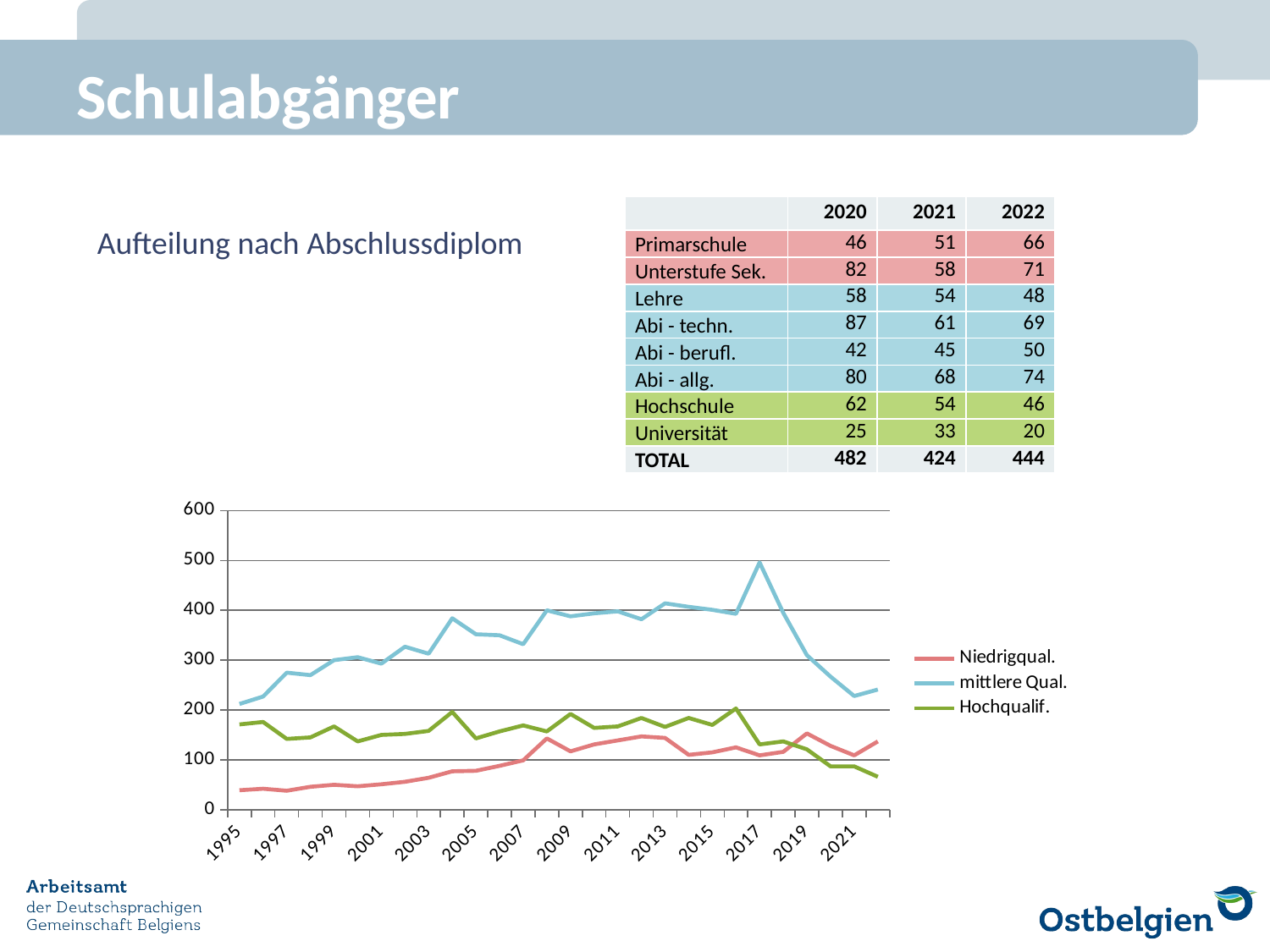
Does the mittlere Qual. series rise or fall between 2017 and 2022? fall Is the value for Hochqualif. in 2022 greater or less than 100? less Is the value for mittlere Qual. in 2017 greater or less than 400? greater Is the value for mittlere Qual. in 2021 greater or less than 200? greater Which colour is used for the mittlere Qual. series in the chart? blue In 1995, which is larger: the value for Hochqualif. or the value for Niedrigqual.? Hochqualif. How many series does the chart's legend list? 3 Which series in the chart has the highest values across the whole period? mittlere Qual. In 2022, which is larger: the value for Niedrigqual. or the value for Hochqualif.? Niedrigqual. What kind of chart is shown on the slide? line chart Which series has the lowest value in 2022? Hochqualif.